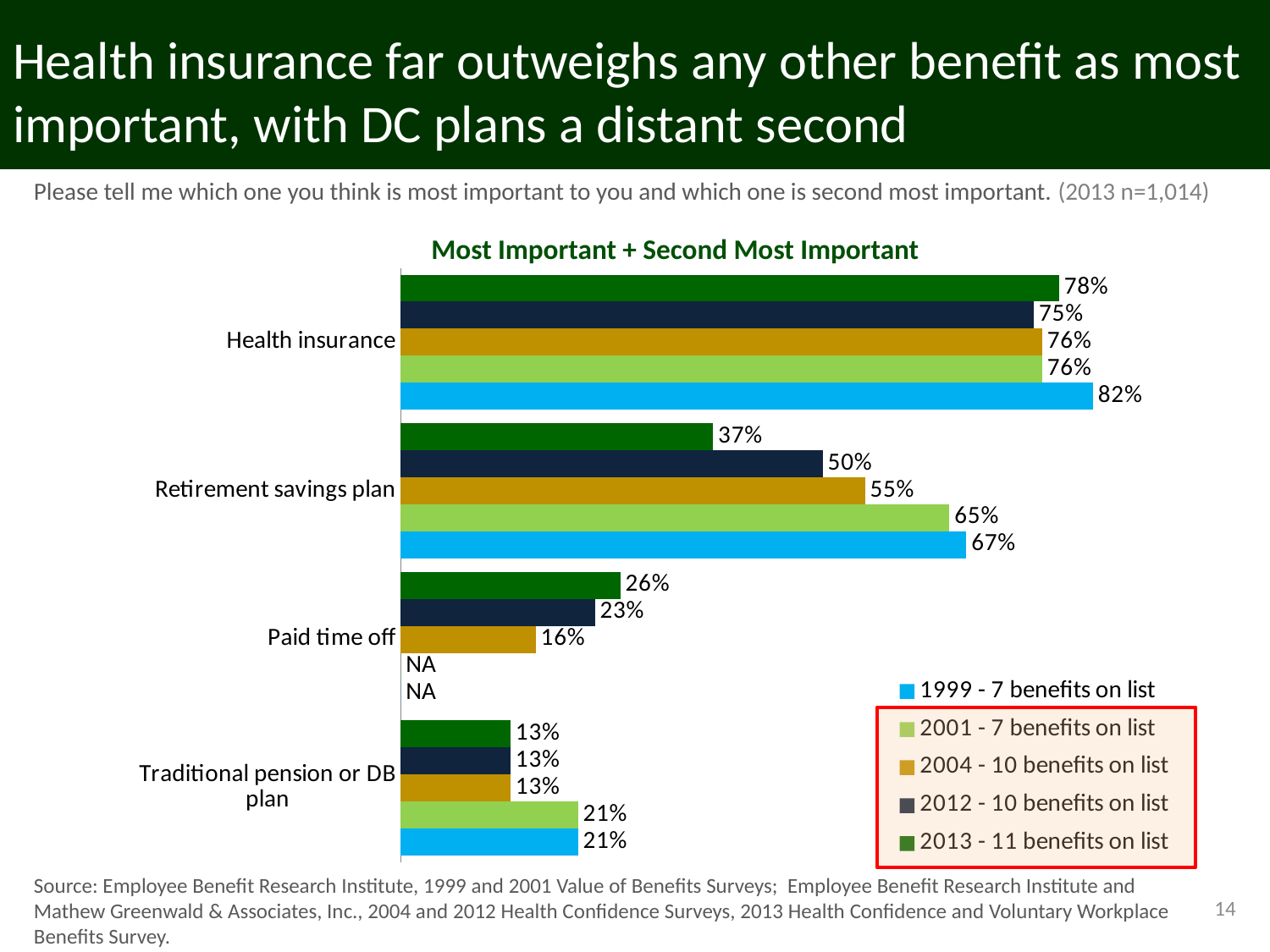
What is the value for Paid time off in the 2004 - 10 benefits on list series? 16% What is the title of the chart? Most Important + Second Most Important What is the value for Traditional pension or DB plan in the 2001 - 7 benefits on list series? 21% How many benefit categories are plotted on the chart? 4 How many series does the legend list? 5 Which benefit category has the lowest value in the 2012 - 10 benefits on list series? Traditional pension or DB plan Which benefit category has the highest value in the 2013 - 11 benefits on list series? Health insurance What is the value for Health insurance in the 1999 - 7 benefits on list series? 82% For Health insurance, which is larger: the 2013 value or the 2012 value? 2013 What is the value for Retirement savings plan in the 2013 - 11 benefits on list series? 37% What kind of chart is shown on the slide? Bar chart What is the difference between the 1999 and 2013 values for Retirement savings plan? 30%